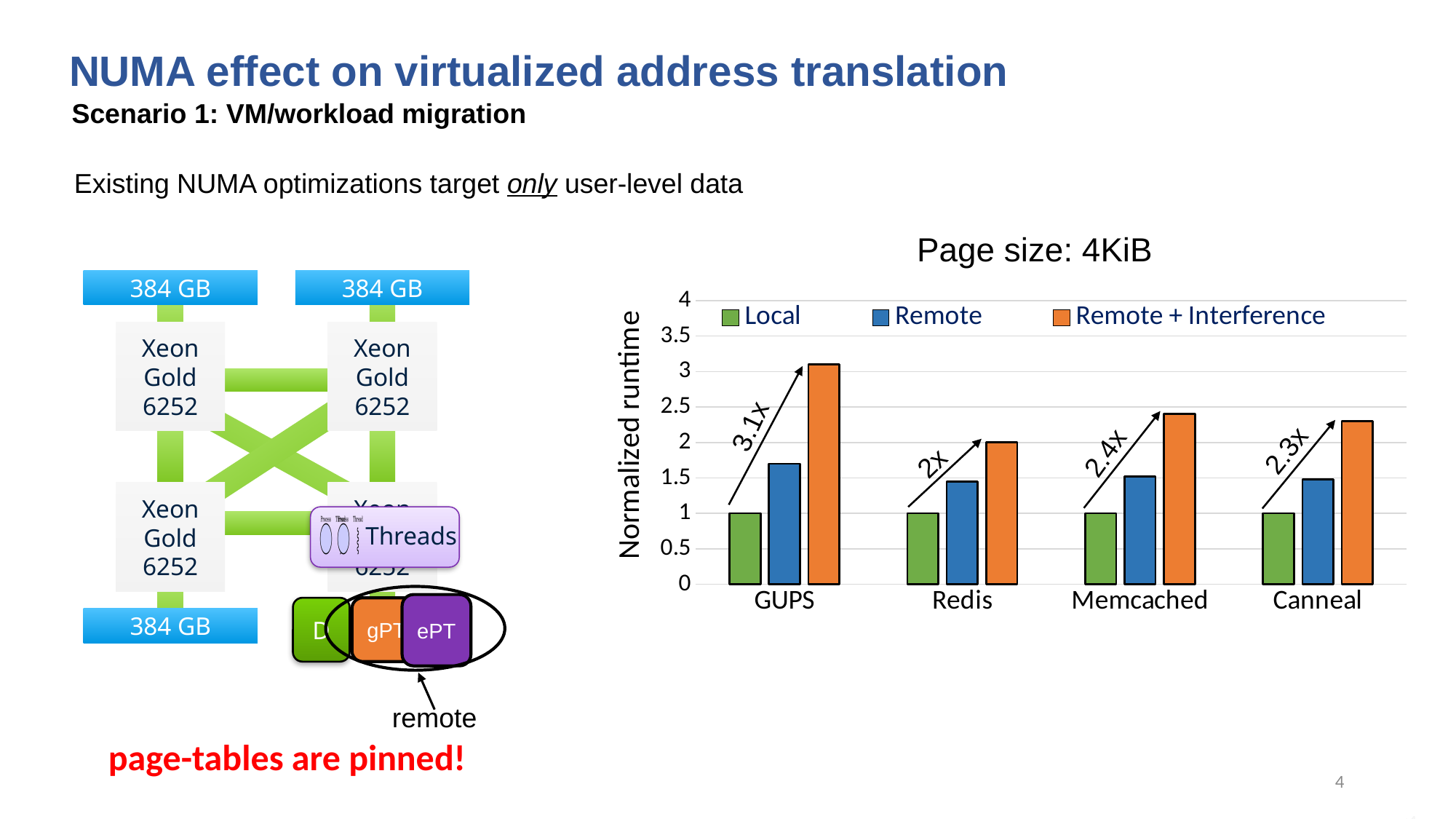
What is the normalized runtime of the Remote + Interference series for Redis? 2 Which workload has the highest Remote + Interference normalized runtime? GUPS What is the normalized runtime of the Local series for GUPS? 1 How many series does the chart legend list? 3 Is the Remote + Interference value for GUPS greater or less than 3? greater What slowdown factor is annotated above the GUPS bars? 3.1x What type of chart is shown on the slide? bar chart What page size is stated in the chart title? 4KiB Which workload has the lowest Remote + Interference normalized runtime? Redis Is the Remote value for GUPS greater or less than 1.5? greater What slowdown factor is annotated above the Memcached bars? 2.4x How many workload categories are shown on the x axis of the chart? 4